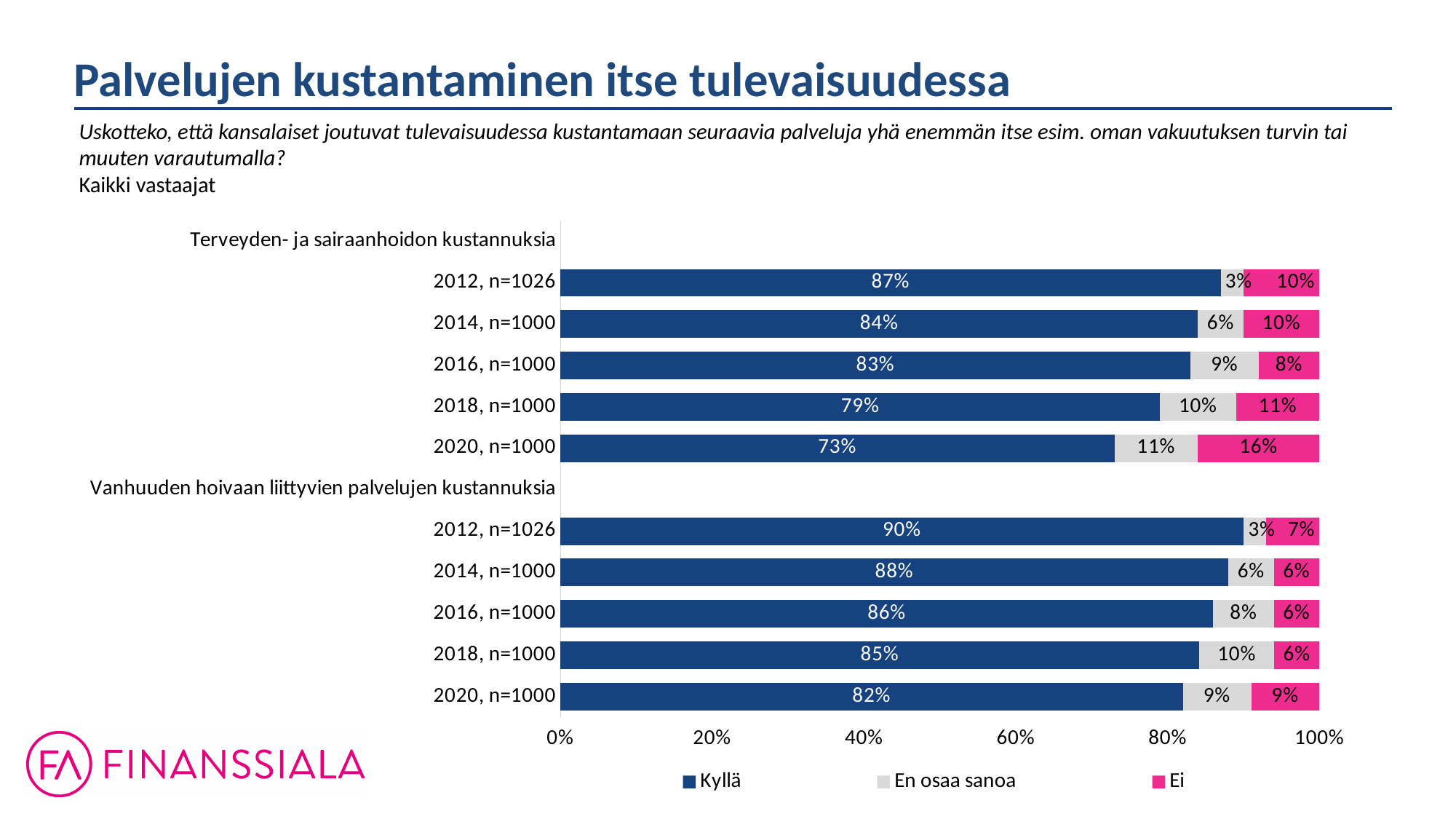
What is the difference between the 'Kyllä' values for 'Terveyden- ja sairaanhoidon kustannuksia' in 2012 and 2020? 14 percentage points Which colour represents the 'Ei' series in the chart? Pink How many series does the legend list? 3 How do the 'Kyllä' values for 'Terveyden- ja sairaanhoidon kustannuksia' change from 2012 to 2020? They fall Which is larger: the 'Ei' value for 'Terveyden- ja sairaanhoidon kustannuksia' in 2020 or the 'Ei' value for 'Vanhuuden hoivaan liittyvien palvelujen kustannuksia' in 2020? Terveyden- ja sairaanhoidon kustannuksia in 2020 What is the 'En osaa sanoa' value for 'Terveyden- ja sairaanhoidon kustannuksia' in 2018, n=1000? 10% How many bars are shown in the chart in total? 10 Which year has the highest 'Kyllä' value for 'Vanhuuden hoivaan liittyvien palvelujen kustannuksia'? 2012, n=1026 Which year has the lowest 'Kyllä' value for 'Terveyden- ja sairaanhoidon kustannuksia'? 2020, n=1000 What is the 'Kyllä' value for 'Terveyden- ja sairaanhoidon kustannuksia' in 2020, n=1000? 73% What is the 'Ei' value for 'Vanhuuden hoivaan liittyvien palvelujen kustannuksia' in 2012, n=1026? 7% What kind of chart is shown on the slide? Stacked bar chart